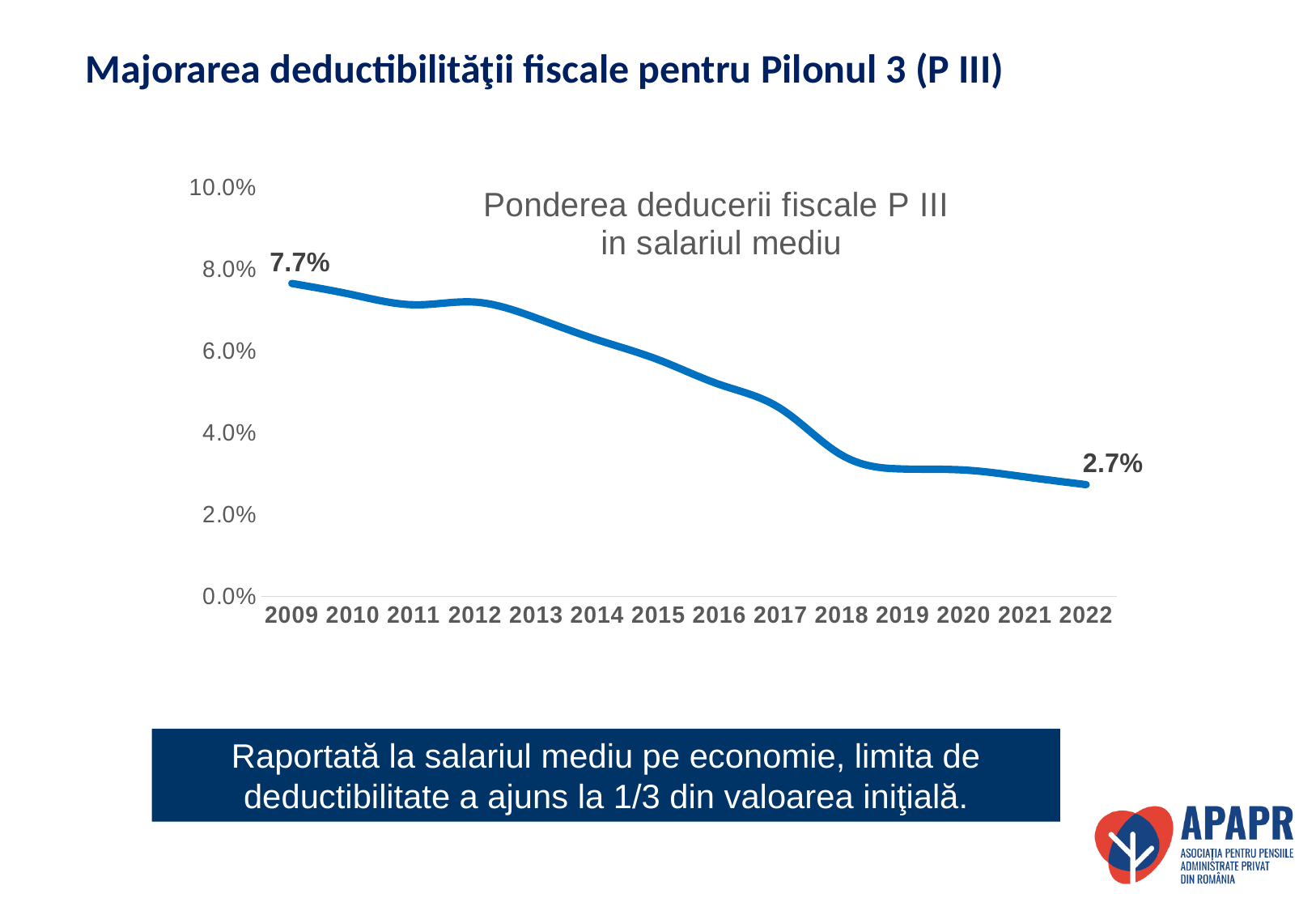
How many years are shown on the x axis? 14 Which is larger, the value for 2013 or the value for 2019? 2013 What is the value for 2022? 2.7% What is the difference between the 2009 value and the 2022 value? 5.0% Which year has the lowest value? 2022 Is the value for 2018 greater or less than 4.0%? less Is the value for 2016 greater or less than 4.0%? greater Do the values rise or fall from 2009 to 2022? Fall What is the value for 2009? 7.7% What kind of chart is this? Line chart What is the title of the chart? Ponderea deducerii fiscale P III in salariul mediu Which year has the highest value? 2009